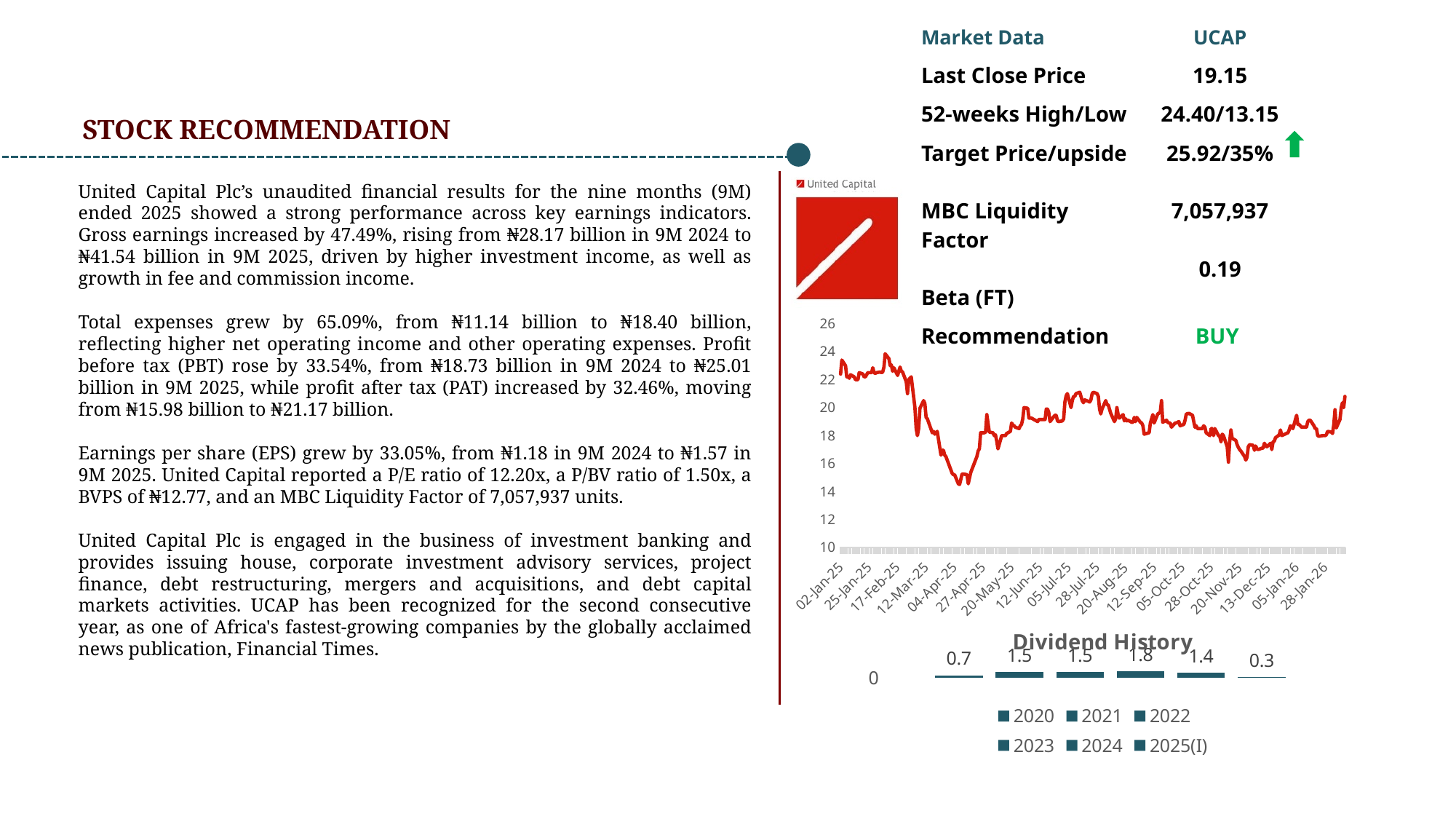
What kind of chart is the Dividend History chart? bar chart In the Dividend History chart, what is the dividend value for 2025(I)? 0.3 What kind of chart is the stock price chart above the Dividend History chart? line chart In the Dividend History chart, which year has the highest dividend? 2023 How many entries does the legend of the Dividend History chart list? 6 In the stock price line chart, is the lowest point of the line, around 04-Apr-25, greater or less than 16? less In the Dividend History chart, what is the dividend value for 2020? 0.7 In the Dividend History chart, which is larger, the dividend for 2020 or for 2024? 2024 In the stock price line chart, is the value at 02-Jan-25 greater or less than 22? greater In the Dividend History chart, what is the dividend value for 2023? 1.8 In the Dividend History chart, what is the difference between the 2023 and 2024 dividend values? 0.4 In the Dividend History chart, which year has the lowest dividend? 2025(I)